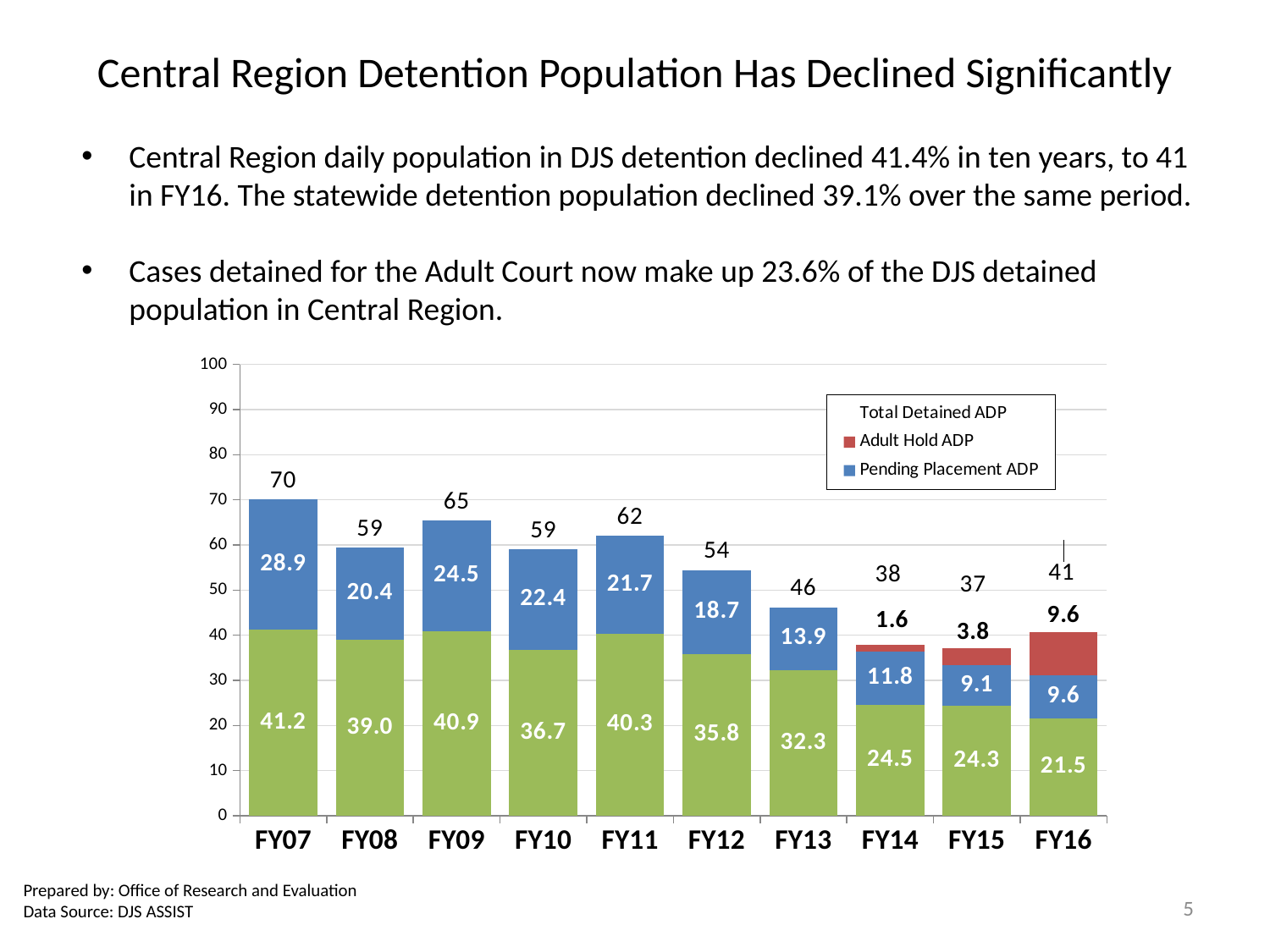
How many series does the chart legend list? 3 What is the Adult Hold ADP value for FY16? 9.6 What is the difference between the Adult Hold ADP in FY16 and in FY15? 5.8 Does the Total Detained ADP generally rise or fall from FY07 to FY16? Fall What is the difference between the Total Detained ADP in FY07 and in FY16? 29 Which fiscal year has the highest Total Detained ADP? FY07 Which is larger, the Pending Placement ADP in FY07 or in FY16? FY07 Which fiscal year has the lowest Total Detained ADP? FY16 What is the Pending Placement ADP value for FY09? 24.5 What kind of chart is shown on the slide? Stacked bar chart How many fiscal years are shown on the x axis of the chart? 10 What is the Total Detained ADP for FY07? 70